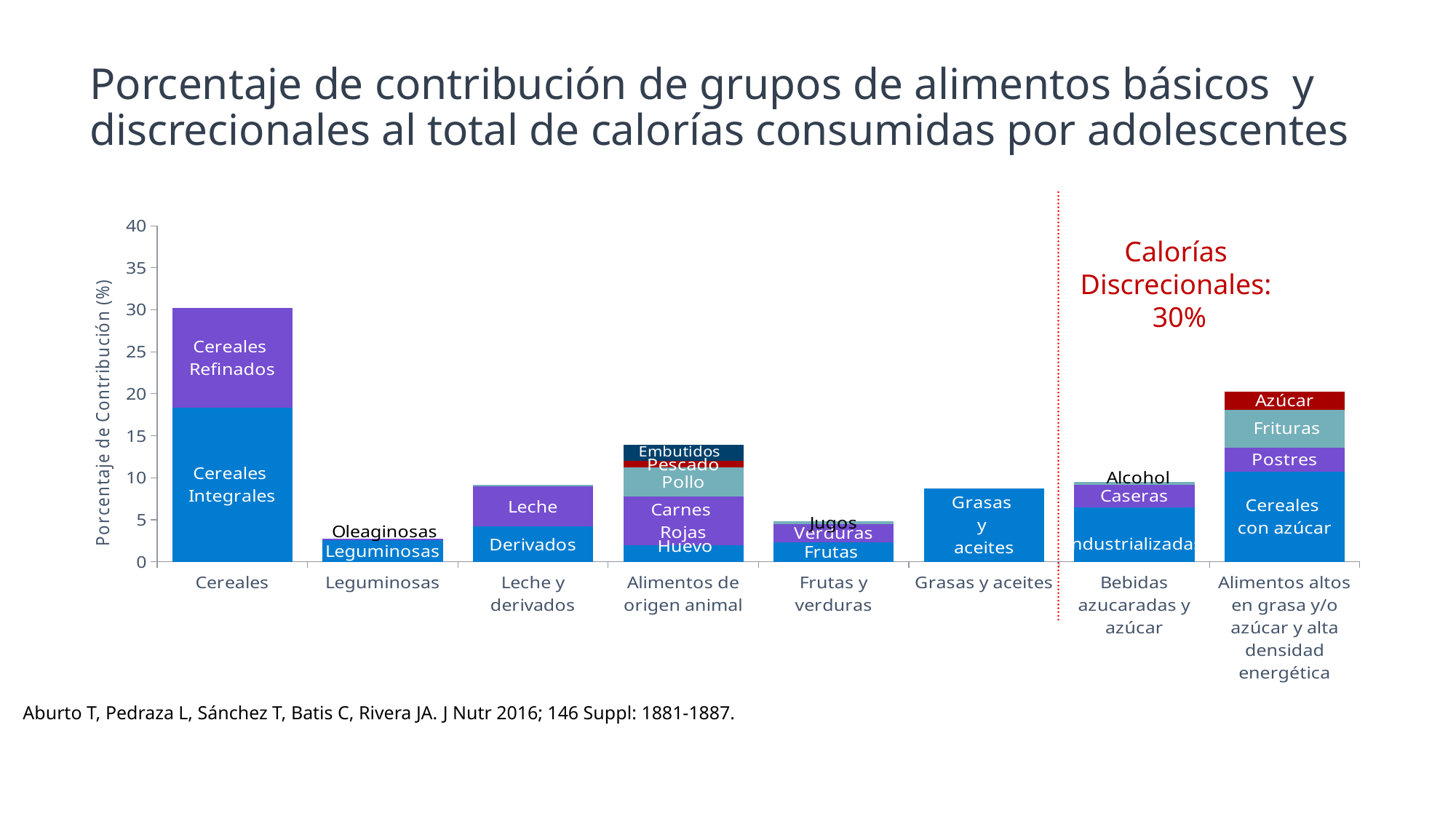
Is the total value for Cereales greater or less than 25? greater Is the total value for Alimentos altos en grasa y/o azúcar y alta densidad energética greater or less than 15? greater Which food group has the highest total percentage contribution? Cereales How many food group categories are shown on the x axis? 8 What percentage of calories does the slide label as Calorías Discrecionales? 30% Is the total value for Leguminosas greater or less than 5? less What is the title of the y axis? Porcentaje de Contribución (%) What kind of chart is shown on the slide? Stacked bar chart Which is larger, the total for Frutas y verduras or the total for Leguminosas? Frutas y verduras Which is larger, the total for Alimentos de origen animal or the total for Alimentos altos en grasa y/o azúcar y alta densidad energética? Alimentos altos en grasa y/o azúcar y alta densidad energética Which food group has the lowest total percentage contribution? Leguminosas